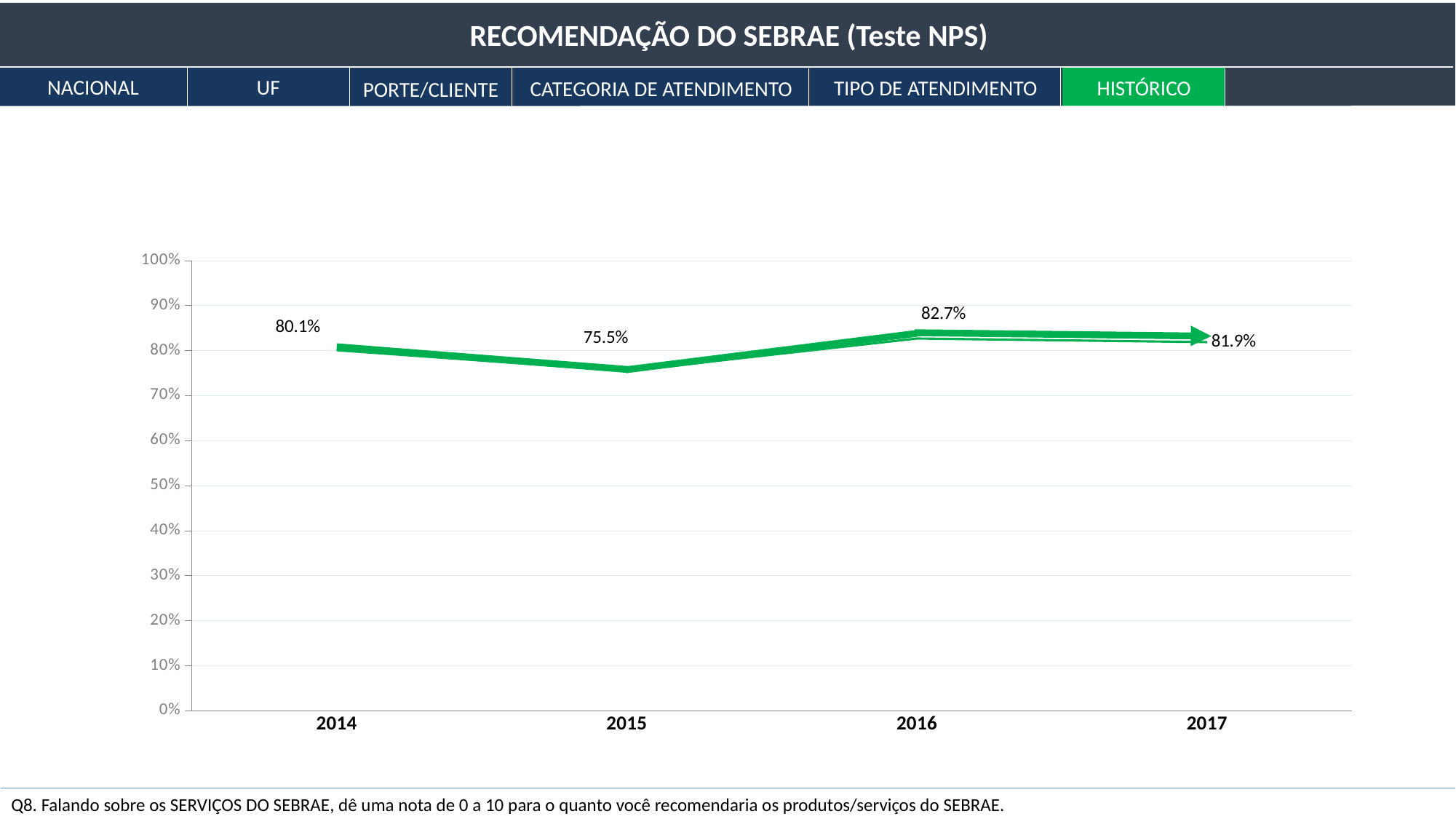
What is the value for 2016? 82.7% What is the value for 2015? 75.5% What is the value for 2014? 80.1% Which year has the lowest value? 2015 What kind of chart is shown on the slide? line chart Which is larger, the value for 2014 or the value for 2015? 2014 What is the difference between the values for 2014 and 2015? 4.6% Does the value rise or fall from 2015 to 2016? rise What is the difference between the values for 2016 and 2015? 7.2% How many years are plotted on the chart? 4 Which year has the highest value? 2016 What is the value for 2017? 81.9%